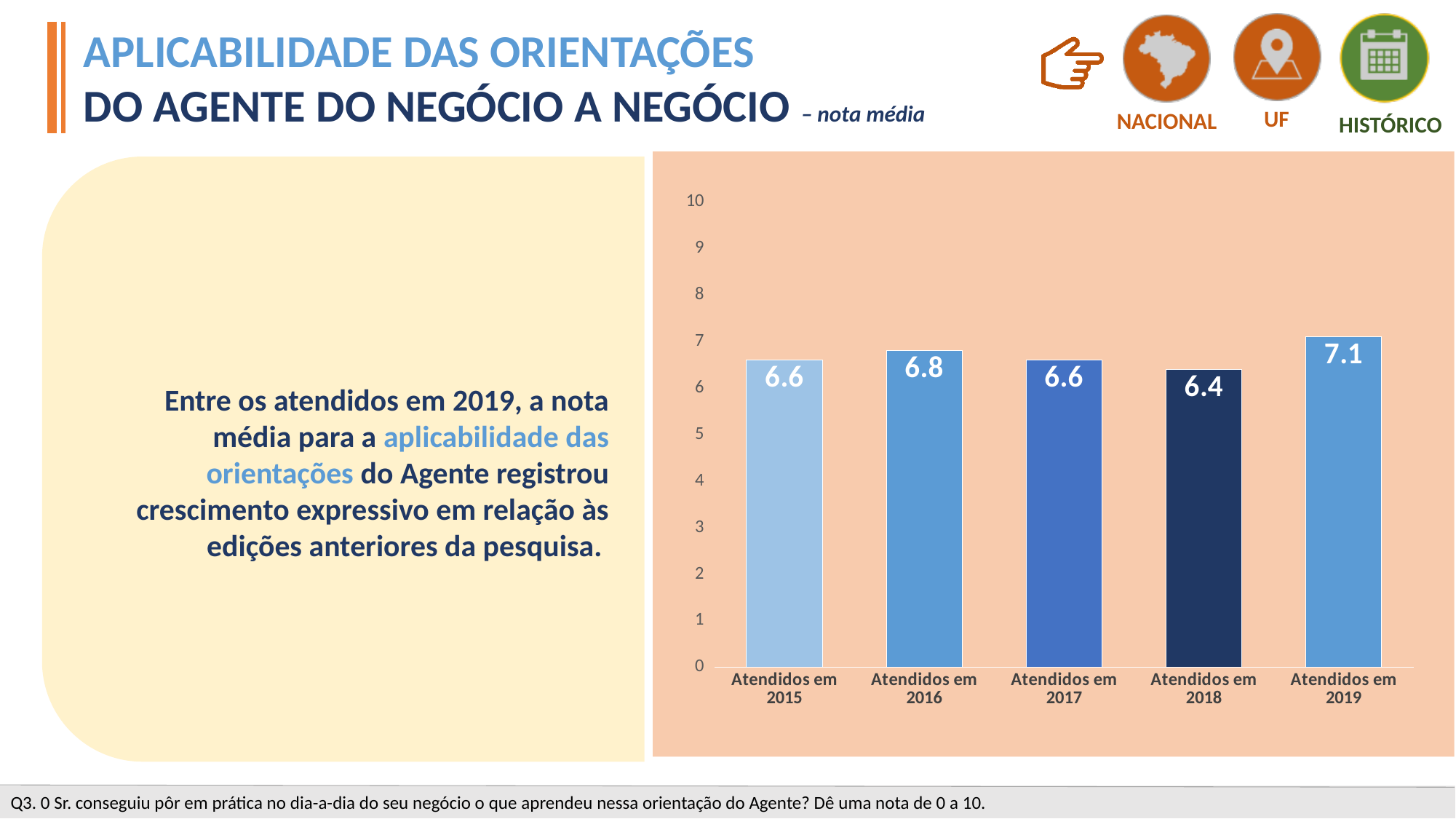
What is the value for Atendidos em 2018? 6.4 What is the value for Atendidos em 2015? 6.6 How many categories are shown on the chart? 5 What is the difference between the values for Atendidos em 2019 and Atendidos em 2018? 0.7 What is the maximum value shown on the vertical axis? 10 Which is larger, the value for Atendidos em 2016 or Atendidos em 2017? Atendidos em 2016 Is the value for Atendidos em 2019 greater or less than 7? greater What is the value for Atendidos em 2019? 7.1 Which category has the lowest value? Atendidos em 2018 What kind of chart is shown on the slide? bar chart What is the value for Atendidos em 2016? 6.8 Which category has the highest value? Atendidos em 2019